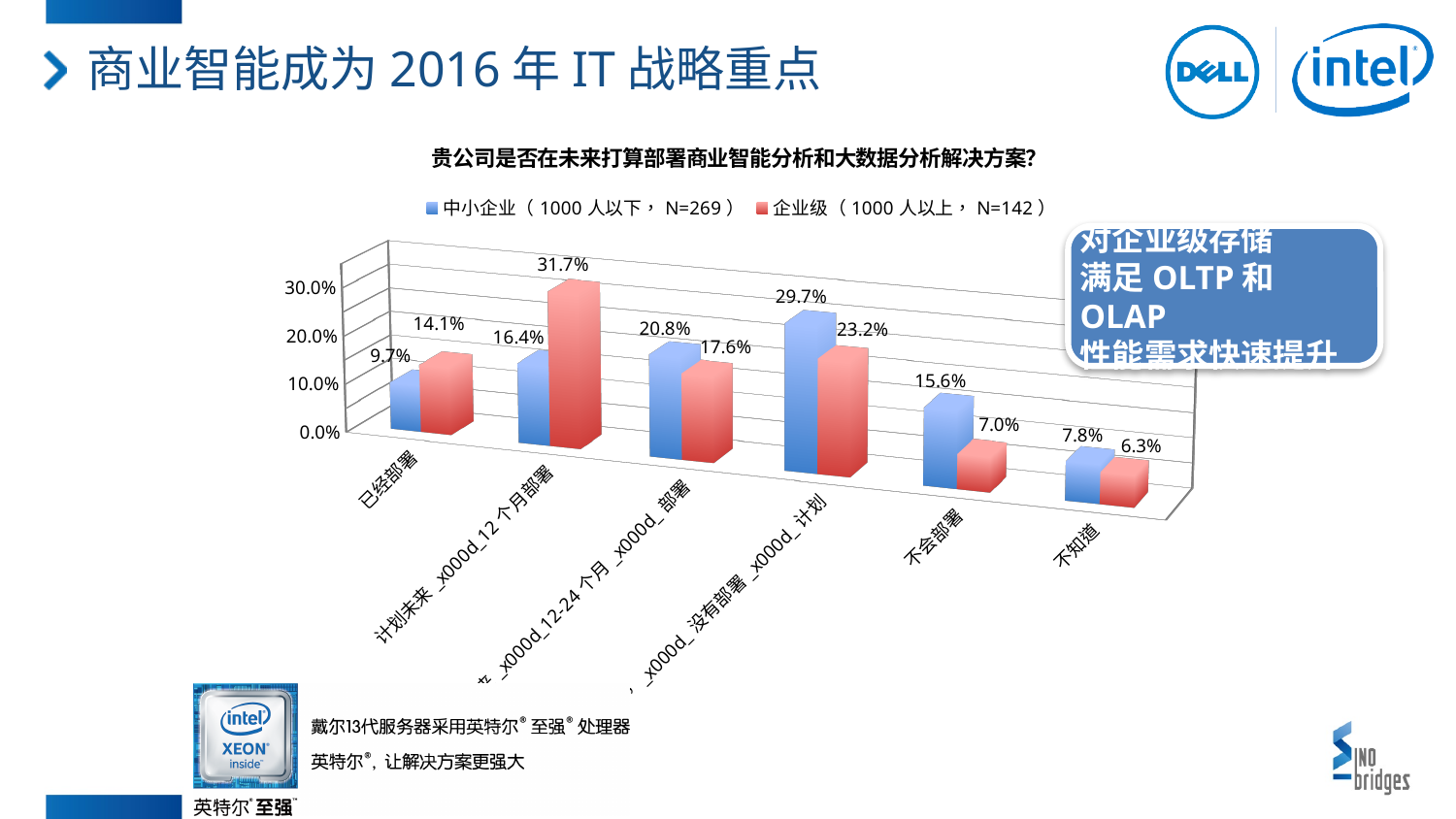
What is the value for 中小企业 in the 已经部署 category? 9.7% What is the value for 企业级 in the 不知道 category? 6.3% What is the value for 中小企业 in the 不会部署 category? 15.6% What type of chart is shown on the slide? bar chart How many series does the legend list? 2 What is the difference between the 企业级 and 中小企业 values in the 计划未来 12 个月部署 category? 15.3% How many categories are shown on the x axis? 6 Which category has the lowest value for the 中小企业 series? 不知道 Which category has the highest value for the 企业级 series? 计划未来 12 个月部署 What is the value for 企业级 in the 已经部署 category? 14.1% What is the value for 企业级 in the 计划未来 12 个月部署 category? 31.7% In the 不会部署 category, which series has the larger value, 中小企业 or 企业级? 中小企业